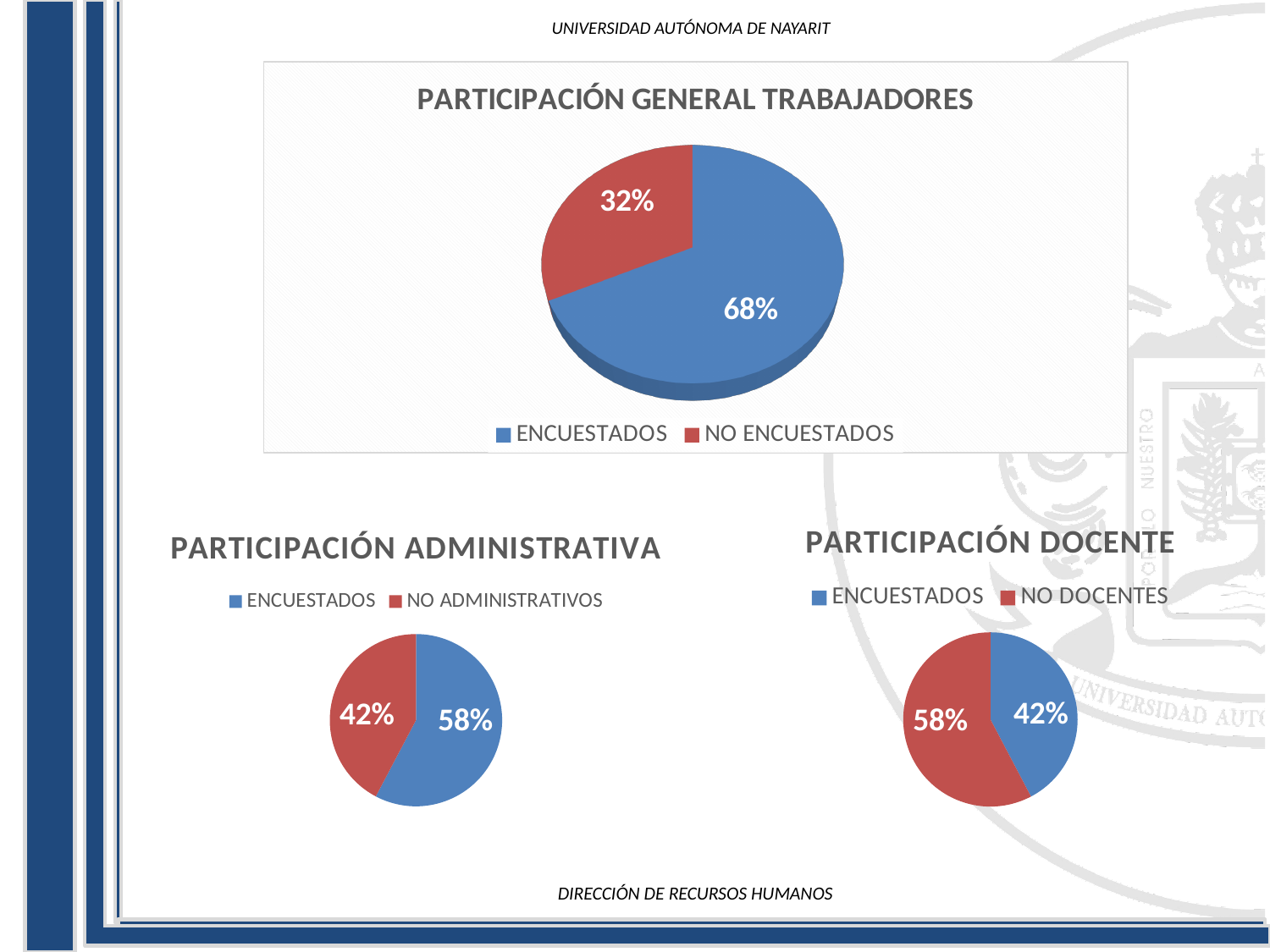
How many entries does the legend of the 'PARTICIPACIÓN DOCENTE' chart list? 2 In the 'PARTICIPACIÓN GENERAL TRABAJADORES' chart, what share of the pie is NO ENCUESTADOS? 32% In the 'PARTICIPACIÓN ADMINISTRATIVA' chart, what share of the pie is ENCUESTADOS? 58% In the 'PARTICIPACIÓN GENERAL TRABAJADORES' chart, which slice is the largest? ENCUESTADOS What kind of chart is the 'PARTICIPACIÓN GENERAL TRABAJADORES' chart? Pie chart In the 'PARTICIPACIÓN ADMINISTRATIVA' chart, what share of the pie is NO ADMINISTRATIVOS? 42% In the 'PARTICIPACIÓN GENERAL TRABAJADORES' chart, what is the difference between the ENCUESTADOS and NO ENCUESTADOS shares? 36% In the 'PARTICIPACIÓN DOCENTE' chart, which is larger, ENCUESTADOS or NO DOCENTES? NO DOCENTES In the 'PARTICIPACIÓN ADMINISTRATIVA' chart, which slice is the smallest? NO ADMINISTRATIVOS